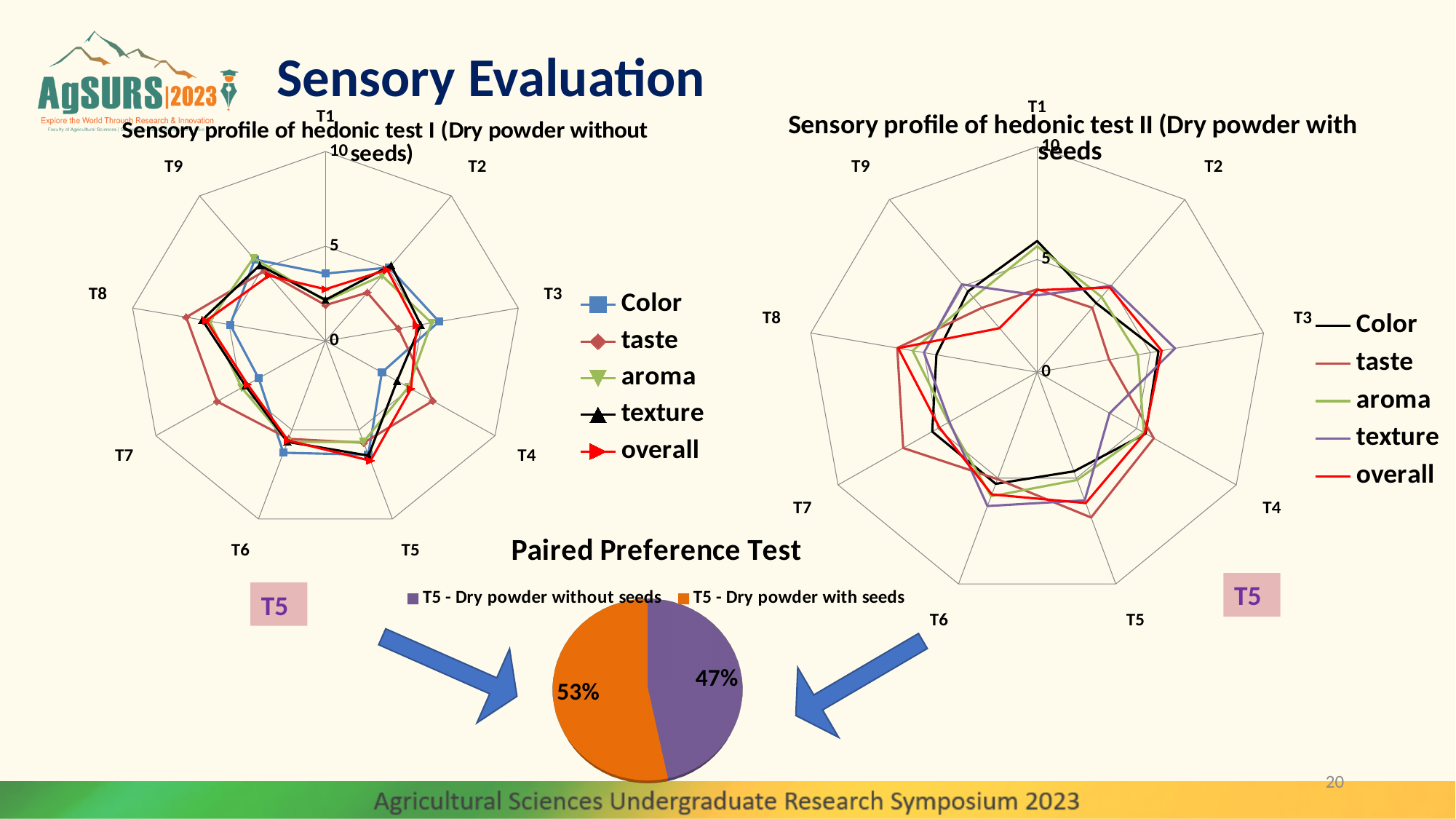
In the Paired Preference Test pie chart, what percentage is shown for T5 - Dry powder without seeds? 47% In the chart titled 'Sensory profile of hedonic test I (Dry powder without seeds)', how many treatment categories (T labels) are plotted around the chart? 9 In the Paired Preference Test pie chart, what is the difference between the two slices' percentages? 6% In the chart titled 'Sensory profile of hedonic test I (Dry powder without seeds)', is the taste value for T8 greater or less than 5? greater What kind of chart is the Paired Preference Test chart? Pie chart In the chart titled 'Sensory profile of hedonic test II (Dry powder with seeds)', how many series does the legend list? 5 In the chart titled 'Sensory profile of hedonic test I (Dry powder without seeds)', is the Color value for T1 greater or less than 5? less What kind of chart is 'Sensory profile of hedonic test II (Dry powder with seeds)'? Radar chart How many slices does the Paired Preference Test pie chart have? 2 In the chart titled 'Sensory profile of hedonic test I (Dry powder without seeds)', how many series does the legend list? 5 In the Paired Preference Test pie chart, which slice is larger: Dry powder with seeds or Dry powder without seeds? Dry powder with seeds In the Paired Preference Test pie chart, what percentage is shown for T5 - Dry powder with seeds? 53%